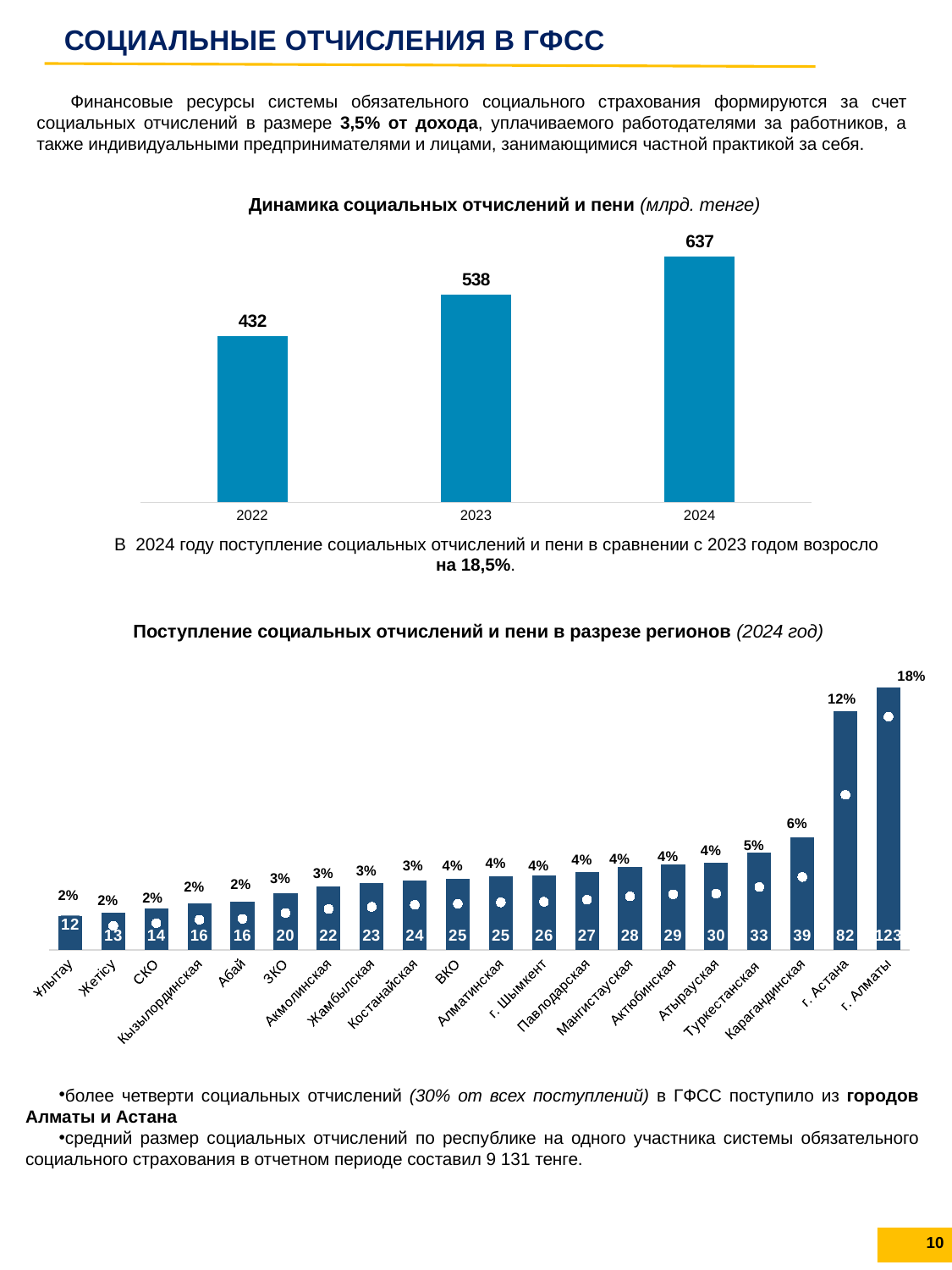
In the chart 'Поступление социальных отчислений и пени в разрезе регионов', which is larger: the value for Туркестанская or the value for Атырауская? Туркестанская In the chart 'Поступление социальных отчислений и пени в разрезе регионов', how many regions are plotted? 20 In the chart 'Поступление социальных отчислений и пени в разрезе регионов', which region has the highest value? г. Алматы In the chart 'Динамика социальных отчислений и пени', how many years are plotted? 3 What kind of chart is 'Динамика социальных отчислений и пени'? bar chart In the chart 'Поступление социальных отчислений и пени в разрезе регионов', which region has the lowest value? Ұлытау In the chart 'Поступление социальных отчислений и пени в разрезе регионов', what is the value for Карагандинская? 39 In the chart 'Динамика социальных отчислений и пени', what is the difference between the 2024 and 2022 values? 205 In the chart 'Динамика социальных отчислений и пени', which year has the highest value? 2024 In the chart 'Динамика социальных отчислений и пени', what is the value for 2023? 538 In the chart 'Поступление социальных отчислений и пени в разрезе регионов', what percentage share is shown for г. Астана? 12% In the chart 'Динамика социальных отчислений и пени', do the values rise or fall from 2022 to 2024? rise